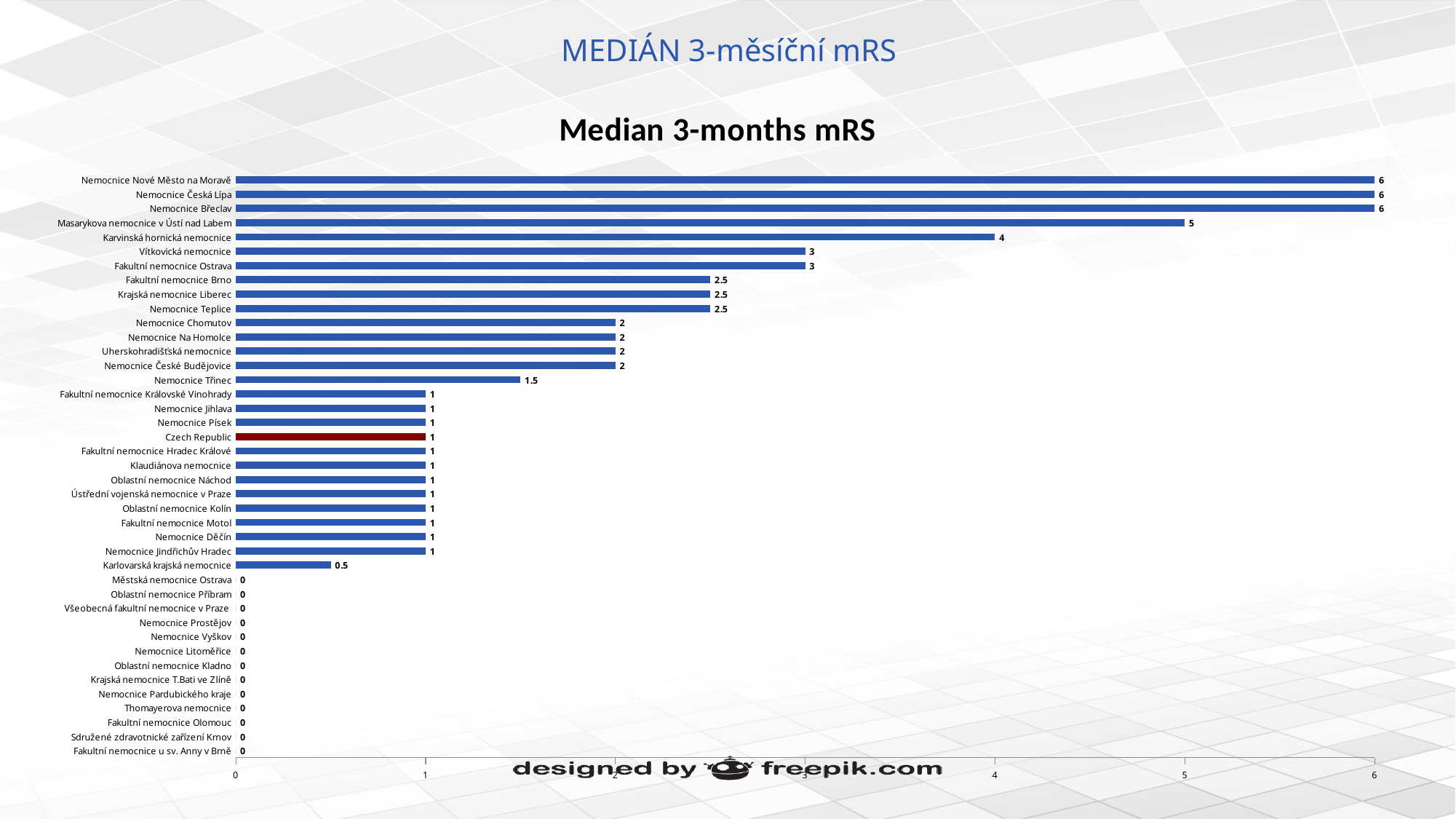
What is the median 3-months mRS for Nemocnice Třinec? 1.5 What is the median 3-months mRS for Masarykova nemocnice v Ústí nad Labem? 5 What is the median 3-months mRS for Karvinská hornická nemocnice? 4 Which has a higher median 3-months mRS, Vítkovická nemocnice or Nemocnice Chomutov? Vítkovická nemocnice What kind of chart is shown on the slide? Bar chart Which category's bar is coloured dark red instead of blue? Czech Republic What is the difference between the median 3-months mRS of Nemocnice Břeclav and Fakultní nemocnice Brno? 3.5 Is the value for Masarykova nemocnice v Ústí nad Labem greater or less than 4? greater How many hospitals/categories are shown in the chart? 41 What is the median 3-months mRS for Karlovarská krajská nemocnice? 0.5 What is the median 3-months mRS for Czech Republic? 1 What is the title of the chart? Median 3-months mRS